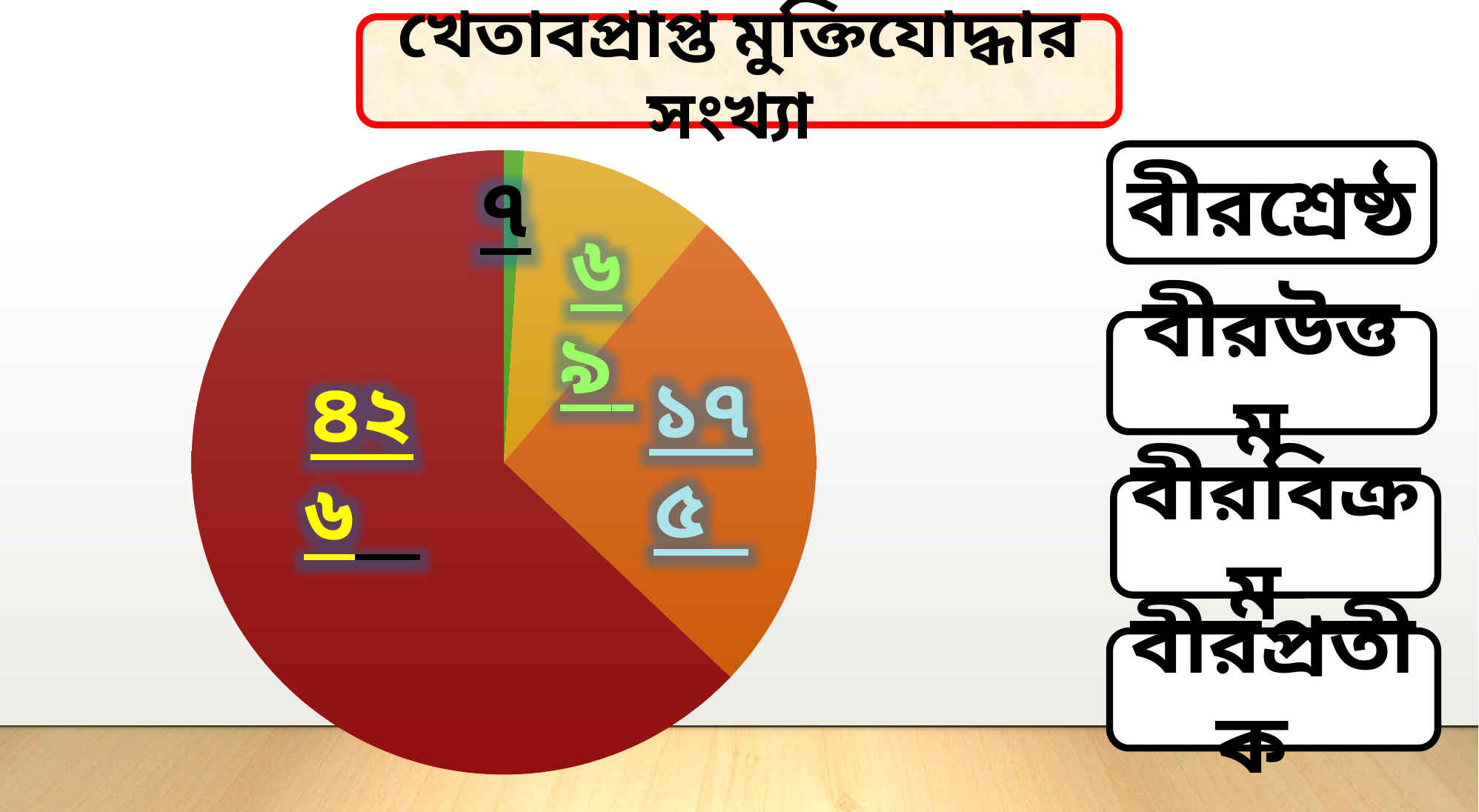
Which slice of the pie chart has the largest value? The dark red slice (৪২৬) What is the total of all four values shown on the pie chart? ৬৭৭ What value is labelled on the orange slice of the pie chart? ১৭৫ What value is labelled on the yellow slice of the pie chart? ৬৯ What kind of chart is shown on the slide? Pie chart Which is larger, the value of the orange slice or the value of the yellow slice? The orange slice (১৭৫) How many slices does the pie chart have? 4 What value is labelled on the large dark red slice of the pie chart? ৪২৬ What value is labelled on the small green slice of the pie chart? ৭ What is the title of the pie chart? খেতাবপ্রাপ্ত মুক্তিযোদ্ধার সংখ্যা Which slice of the pie chart has the smallest value? The green slice (৭) What is the difference between the value of the dark red slice and the value of the orange slice? ২৫১